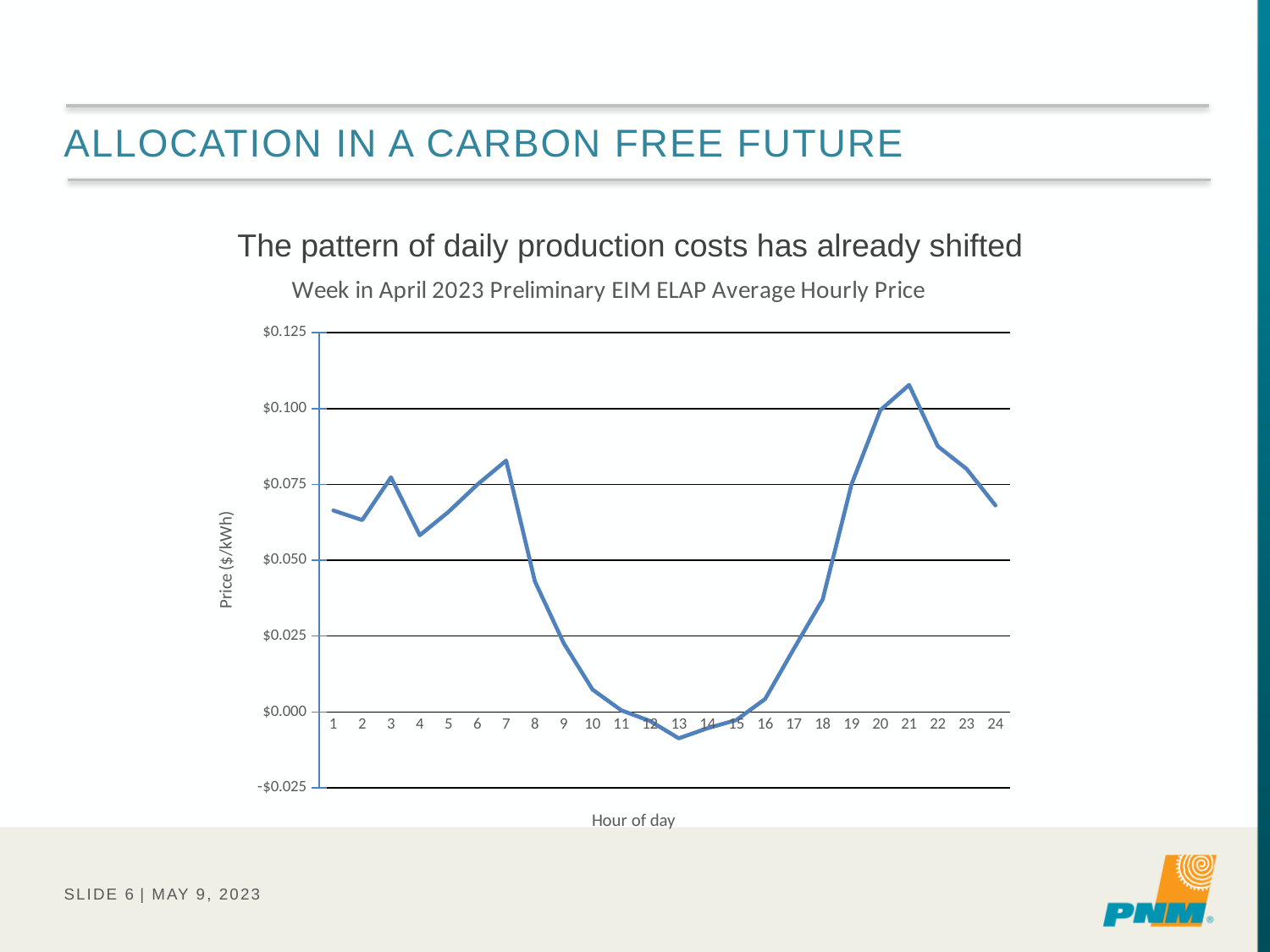
At which hour of the day is the average hourly price lowest? 13 What is the label of the vertical axis? Price ($/kWh) Is the value for hour 4 greater or less than $0.050? greater Do the prices rise or fall from hour 7 to hour 12? fall Is the value for hour 10 greater or less than $0.025? less How many hours of the day are plotted on the x axis? 24 What is the title of the chart? Week in April 2023 Preliminary EIM ELAP Average Hourly Price Which hour has the higher price, hour 3 or hour 4? hour 3 Is the value for hour 13 greater or less than $0.000? less At which hour of the day is the average hourly price highest? 21 What kind of chart is shown on the slide? line chart